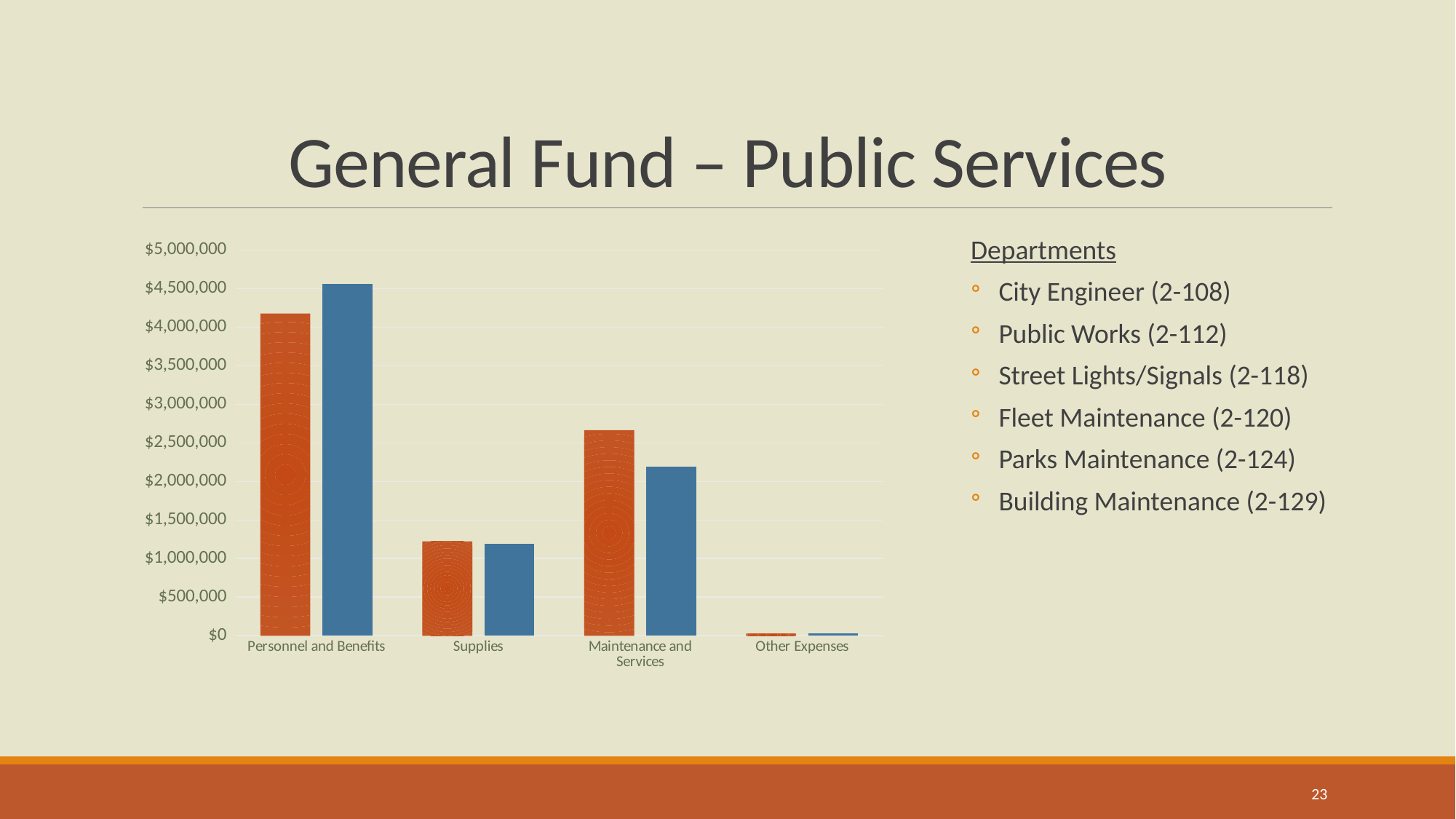
Which category has the smallest bars in the chart? Other Expenses For Personnel and Benefits, is the orange bar or the blue bar taller? blue What is the highest value labelled on the vertical axis of the chart? $5,000,000 Is the orange bar for Personnel and Benefits greater or less than $4,000,000? greater Is the blue bar for Maintenance and Services greater or less than $2,500,000? less Which category has the tallest bar in the chart? Personnel and Benefits Is the orange bar for Maintenance and Services greater or less than $2,500,000? greater For Maintenance and Services, is the orange bar or the blue bar taller? orange What kind of chart is shown on the slide? bar chart How many categories are shown on the x axis of the chart? 4